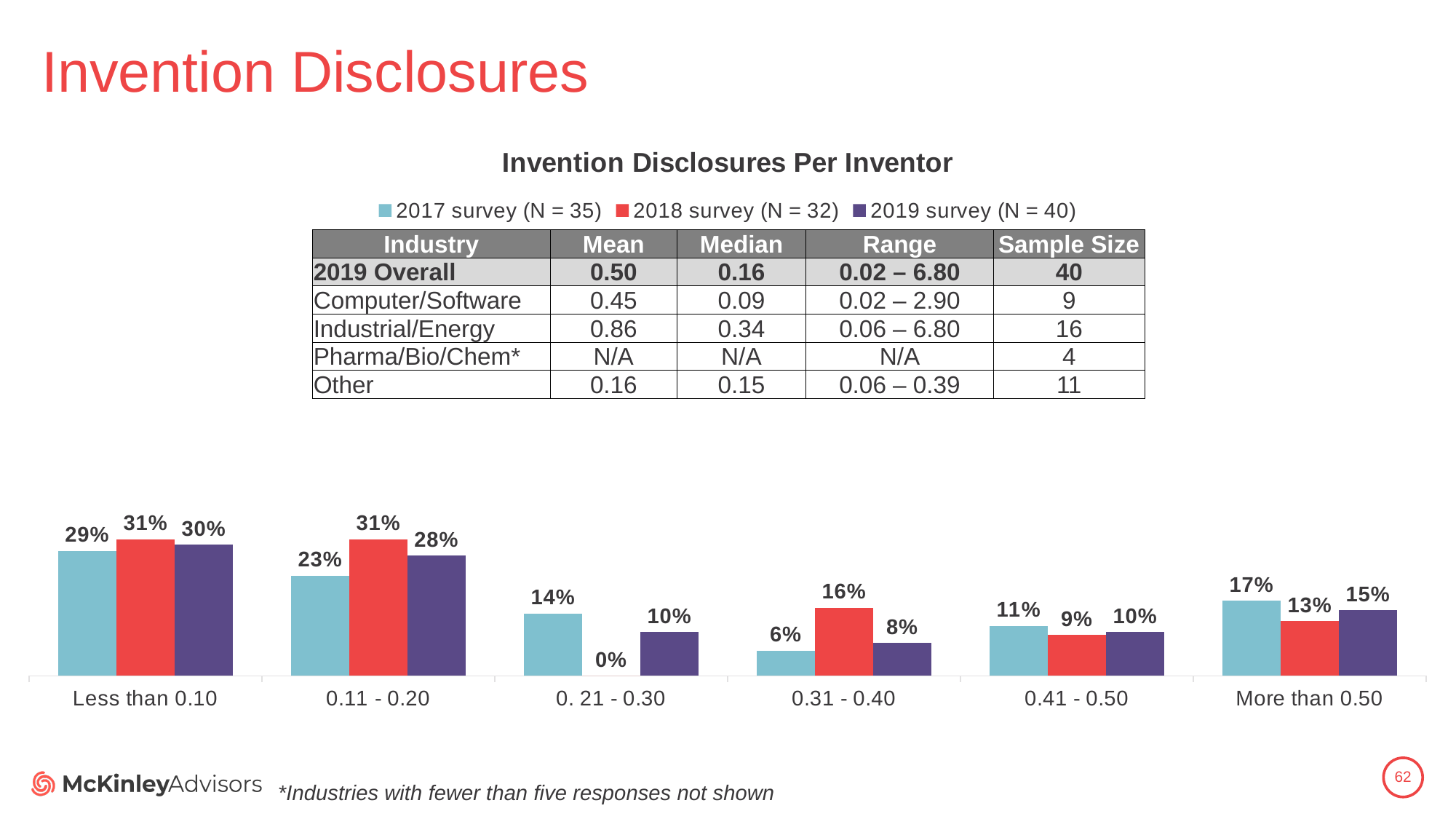
What is the value for the 2019 survey in the '0.31 - 0.40' category? 8% How many series does the chart legend list? 3 Which category has the highest value for the 2017 survey? Less than 0.10 What is the difference between the 2018 survey and 2017 survey values in the '0.11 - 0.20' category? 8% What is the sample size for the 2019 survey according to the legend? N = 40 What is the title of the chart? Invention Disclosures Per Inventor How many categories are shown on the x axis of the chart? 6 What is the value for the 2017 survey in the 'More than 0.50' category? 17% What kind of chart is shown on the slide? Bar chart What is the value for the 2018 survey in the 'Less than 0.10' category? 31% Which category has the lowest value for the 2018 survey? 0. 21 - 0.30 Which is larger in the '0.41 - 0.50' category: the 2017 survey value or the 2018 survey value? 2017 survey